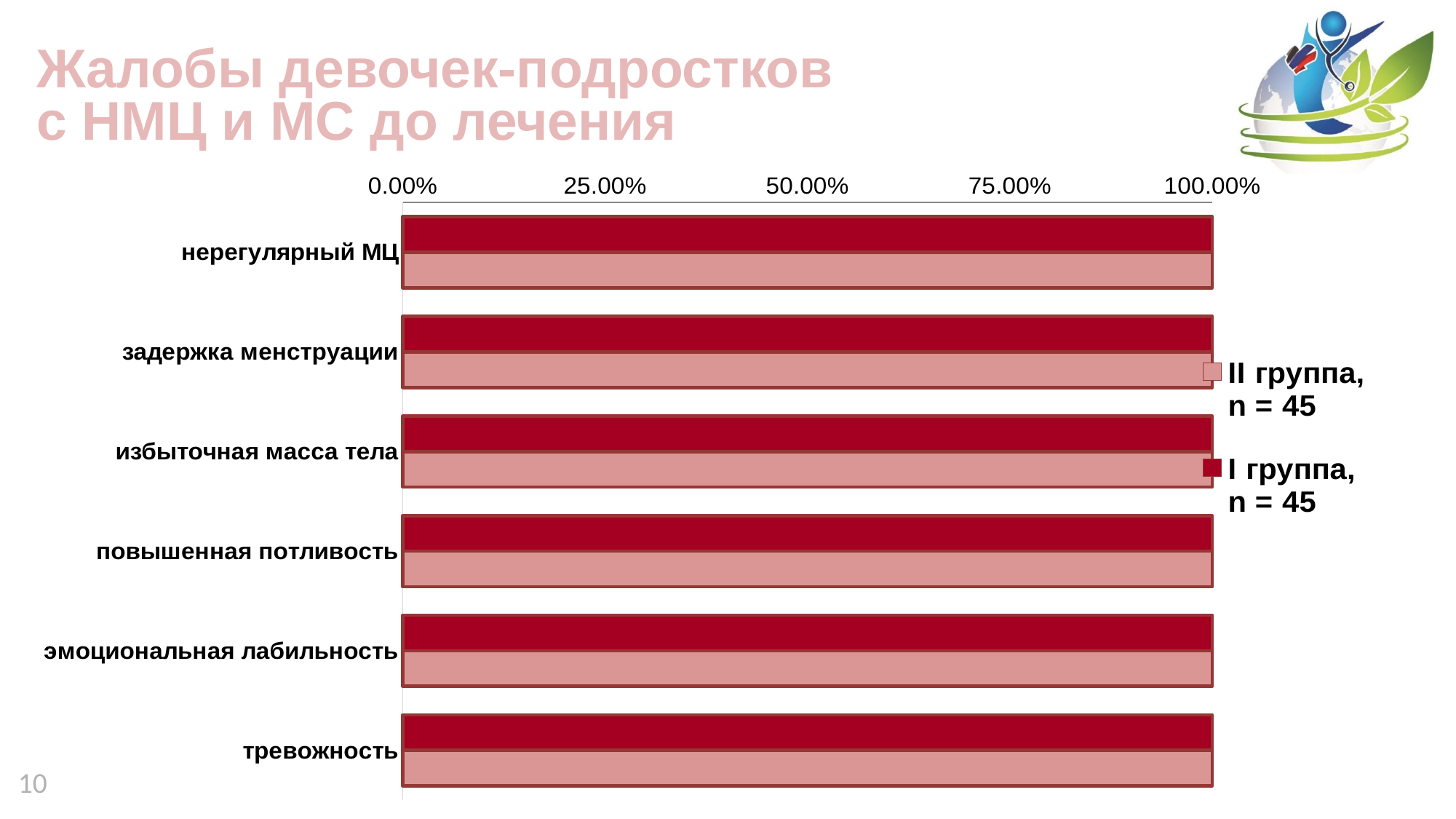
What is the value for 'тревожность' in I группа? 100.00% What is the value for 'повышенная потливость' in II группа? 100.00% What kind of chart is shown on the slide? bar chart What is the value for 'задержка менструации' in I группа? 100.00% What is the value for 'нерегулярный МЦ' in II группа? 100.00% Is the value for 'эмоциональная лабильность' in II группа greater or less than 50.00%? greater What are the two series named in the legend? II группа, n = 45 and I группа, n = 45 What is the highest value shown on the x axis? 100.00% How many complaint categories are listed on the chart? 6 How many series does the legend list? 2 Is the value for 'избыточная масса тела' in I группа greater or less than 75.00%? greater